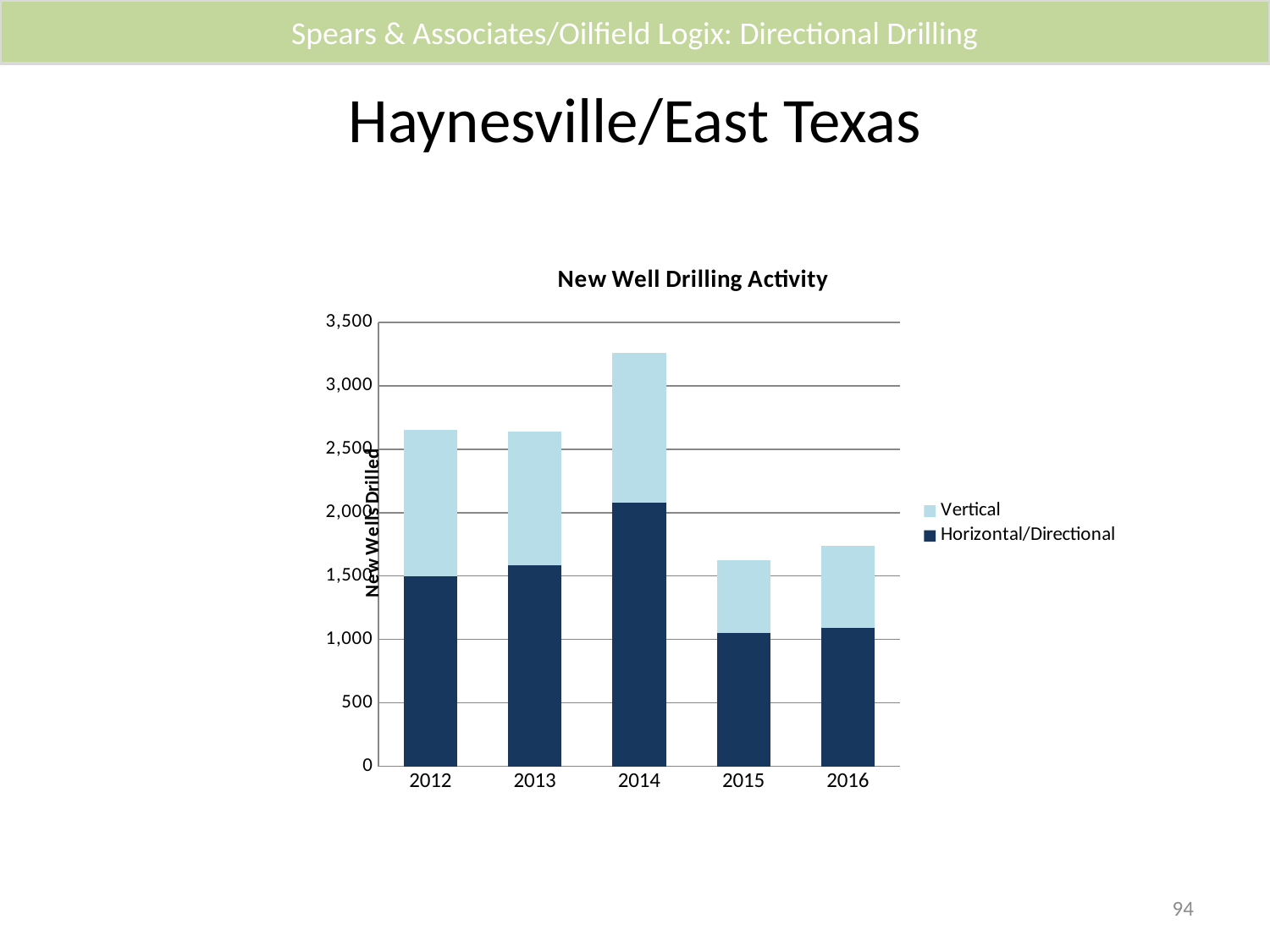
Is the total for 2012 greater or less than 2,500? greater What kind of chart is shown on the slide? Stacked bar chart Is the total for 2014 greater or less than 3,000? greater Which is larger, the Horizontal/Directional value for 2013 or for 2015? 2013 How many years are shown on the x axis? 5 Which year has the lowest total number of new wells drilled? 2015 What is the title of the chart? New Well Drilling Activity Which year has the highest total number of new wells drilled? 2014 Is the total for 2016 greater or less than 2,000? less How many series does the legend list? 2 Which year has the highest Horizontal/Directional value? 2014 Does the total number of new wells drilled rise or fall from 2014 to 2015? fall